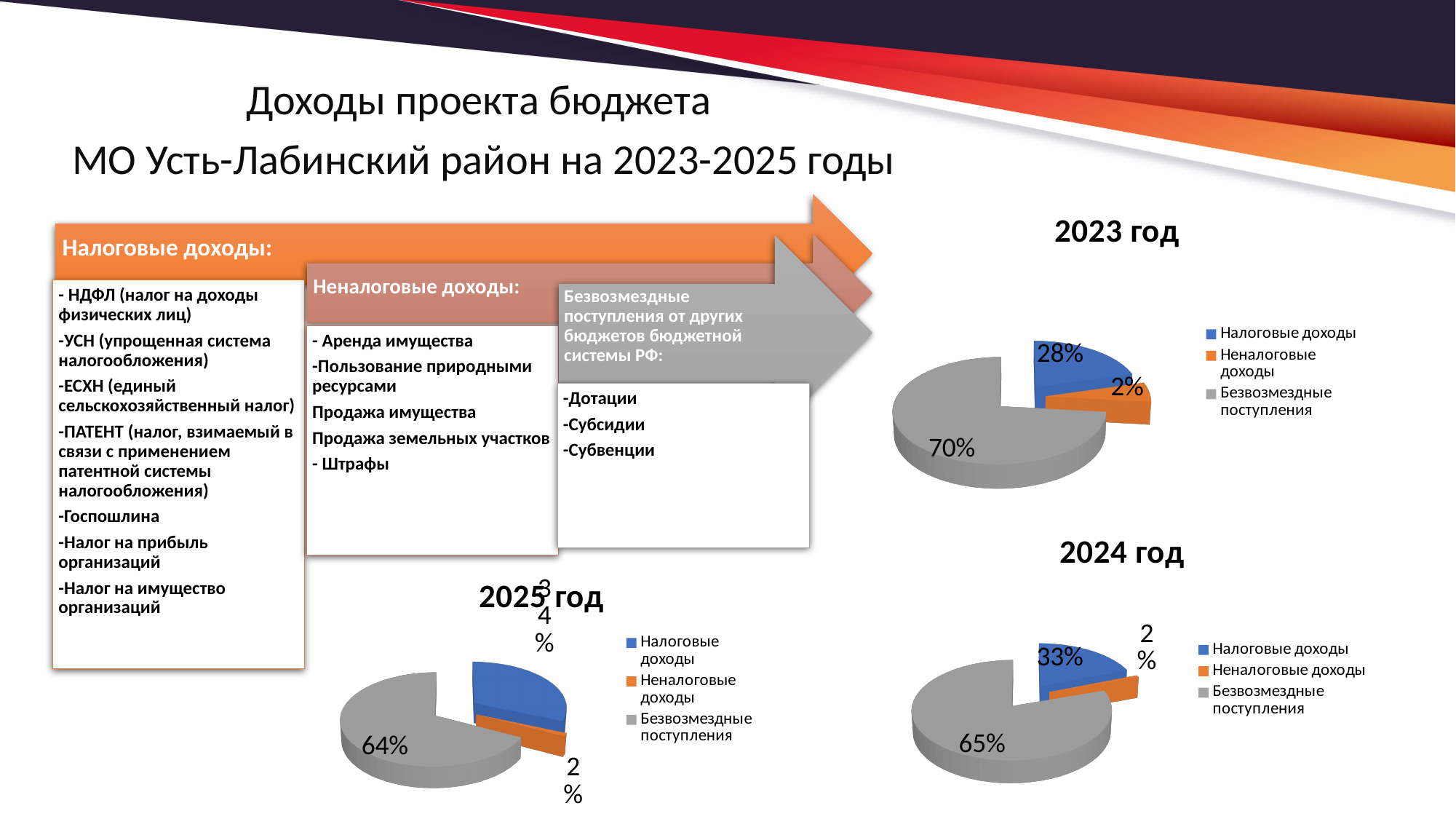
In the "2024 год" chart, what share is labelled for Безвозмездные поступления? 65% In the "2023 год" chart, what share is labelled for Неналоговые доходы? 2% In the "2024 год" chart, what share is labelled for Налоговые доходы? 33% In the "2023 год" chart, what share is labelled for Налоговые доходы? 28% In the "2025 год" chart, what share is labelled for Безвозмездные поступления? 64% In the "2023 год" chart, what is the difference between the shares of Безвозмездные поступления and Налоговые доходы? 42% In the "2025 год" chart, which category has the smallest slice? Неналоговые доходы What kind of chart is the "2023 год" chart? pie chart How many pie charts are shown on the slide? 3 In the "2023 год" chart, what share is labelled for Безвозмездные поступления? 70% How many categories does the legend of the "2024 год" chart list? 3 In the "2024 год" chart, which category has the largest slice? Безвозмездные поступления